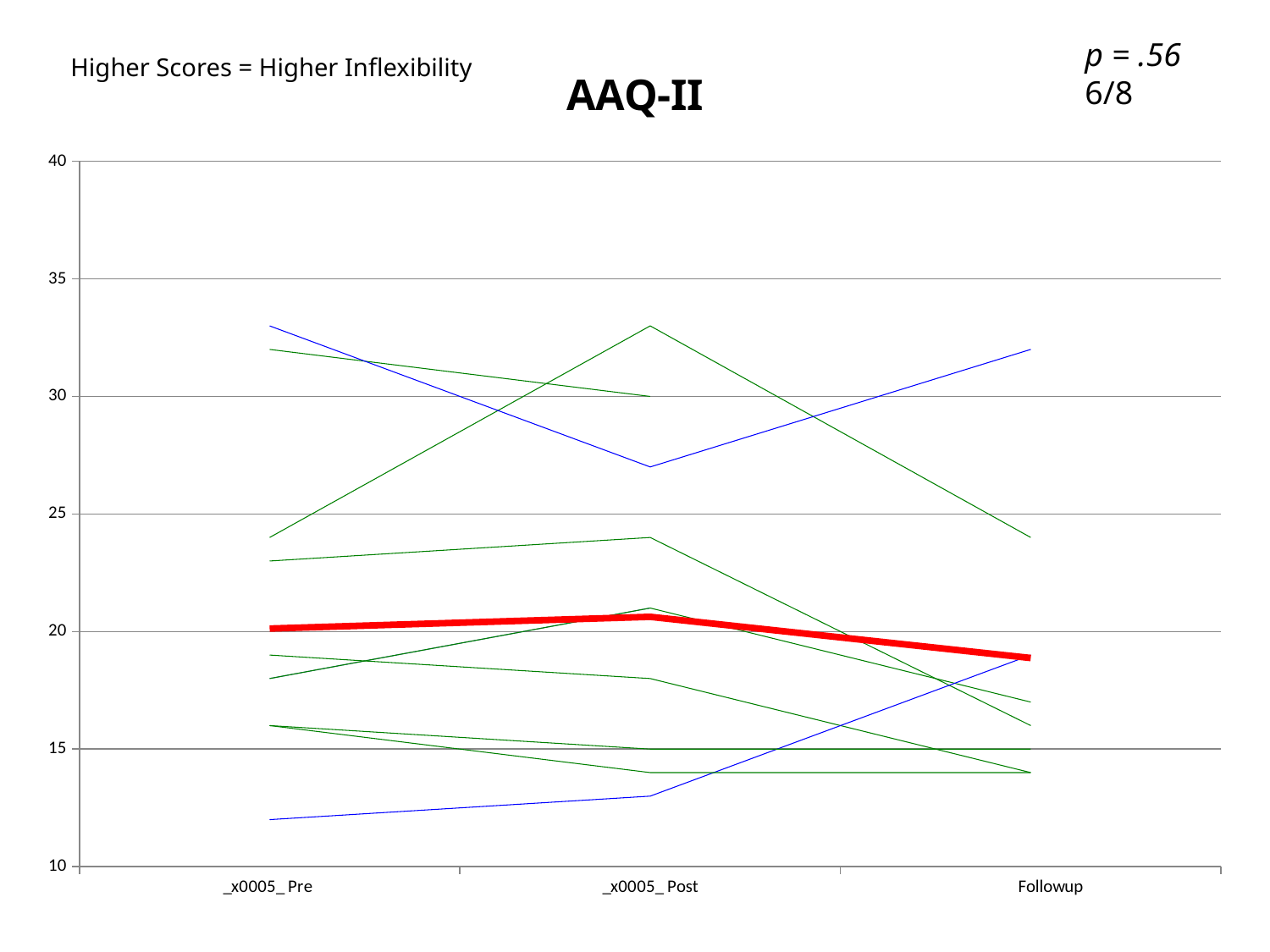
How many categories are shown on the x axis of the chart? 3 Is the value of the highest line at Followup greater or less than 30? greater What is the title of the chart? AAQ-II What is the lowest value shown on the y axis? 10 Is the value of the highest line at _x0005_ Post greater or less than 30? greater What colour is the thick line in the chart? red Is the value of the thick red line at Followup greater or less than 20? less What is the highest value shown on the y axis? 40 What kind of chart is shown on the slide? line chart What is the label of the last category on the x axis? Followup Does the thick red line rise or fall from _x0005_ Post to Followup? fall